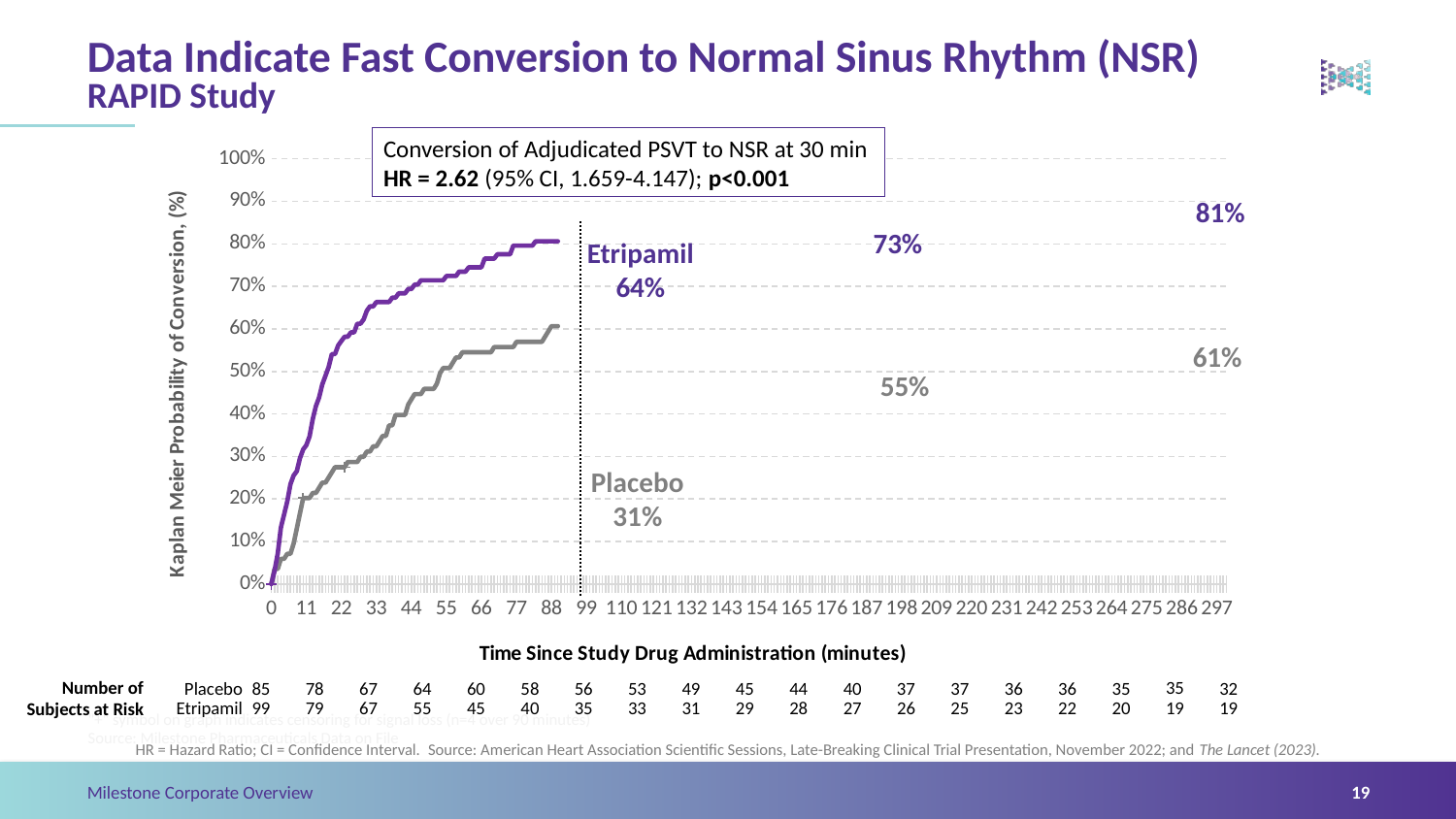
What is the rightmost percentage labelled for Placebo on the chart? 61% What hazard ratio (HR) is reported in the chart's text box? 2.62 Is the Etripamil curve at its end point (around 88 minutes) greater or less than 70%? greater What is the difference between the Etripamil (64%) and Placebo (31%) labels at the dashed line? 33 percentage points How many treatment groups (series) are plotted on the chart? 2 What is the rightmost percentage labelled for Etripamil on the chart? 81% What kind of chart is shown on the slide? Line chart (Kaplan-Meier curve) What conversion percentage is labelled for Placebo next to the dashed vertical line? 31% What is the difference between the 73% Etripamil label and the 55% Placebo label? 18 percentage points What conversion percentage is labelled for Etripamil next to the dashed vertical line? 64% Do the Kaplan-Meier curves rise or fall as time since drug administration increases? Rise Which group has the higher probability of conversion, Etripamil or Placebo? Etripamil